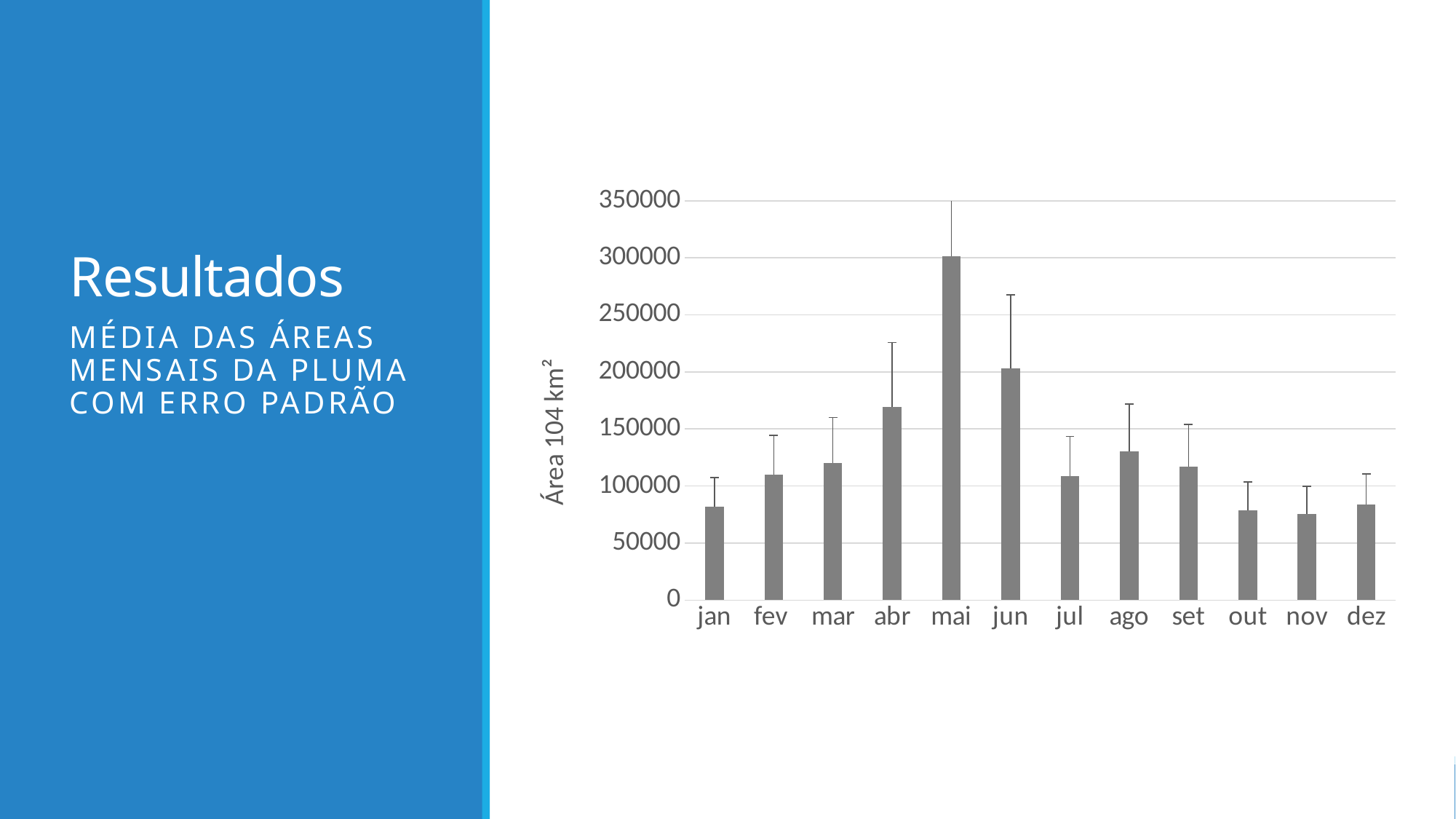
What kind of chart is shown on the slide? bar chart Do the values rise or fall from jan to mai? rise How many months are shown on the x axis of the chart? 12 Is the value for jan greater or less than 100000? less Is the value for abr greater or less than 150000? greater Is the value for mai greater or less than 250000? greater Which is larger, the value for abr or the value for ago? abr What is the label on the y axis of the chart? Área 104 km² Which is larger, the value for mai or the value for jun? mai Which month has the highest bar in the chart? mai